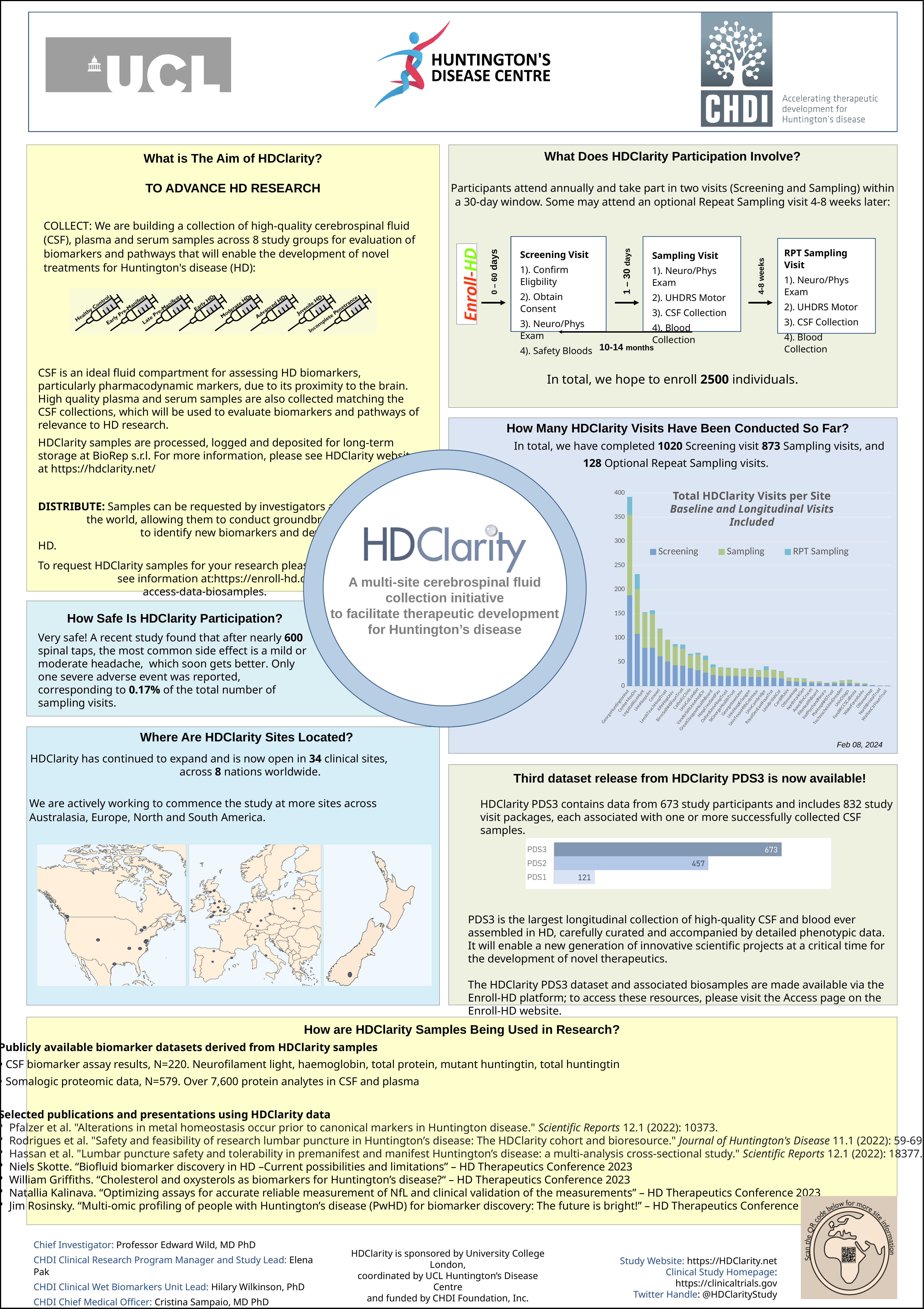
How many series does the legend of the 'Total HDClarity Visits per Site' chart list? 3 What kind of chart is the 'Total HDClarity Visits per Site' chart? Stacked bar chart In the 'Total HDClarity Visits per Site' chart, do the bar totals rise or fall from left to right? Fall How many bars are shown in the 'Third dataset release' chart? 3 In the 'Third dataset release' chart, which dataset has the highest value? PDS3 In the 'Third dataset release' chart, which dataset has the lowest value? PDS1 In the 'Third dataset release' chart, which is larger, PDS2 or PDS1? PDS2 In the 'Third dataset release' chart, what is the value for PDS1? 121 In the 'Third dataset release' chart, what is the value for PDS2? 457 In the 'Third dataset release' chart, what is the difference between the PDS3 and PDS2 values? 216 In the 'Third dataset release' chart, what is the value for PDS3? 673 In the 'Total HDClarity Visits per Site' chart, is the total for the tallest bar greater or less than 350? greater